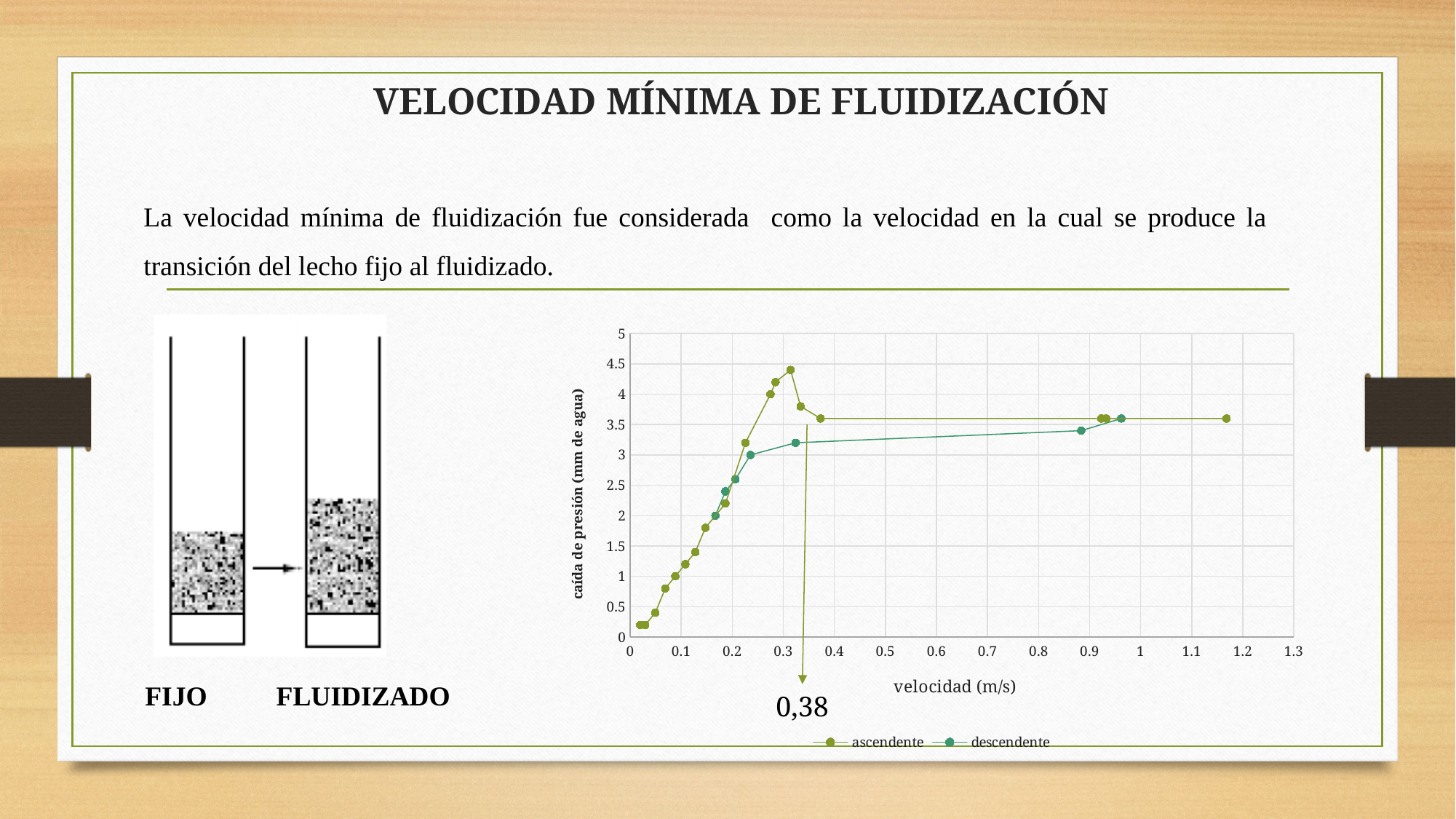
Is the highest value of the ascendente series greater or less than 4? greater What velocity value is marked by the arrow annotation below the chart? 0,38 What kind of chart is shown on the slide? line chart Is the ascendente value at the lowest plotted velocity greater or less than 0.5? less What is the title of the chart's vertical axis? caída de presión (mm de agua) Which series reaches the highest pressure drop on the chart? ascendente What are the two series named in the chart legend? ascendente, descendente Around a velocity of 0.3 m/s, which series shows the higher pressure drop, ascendente or descendente? ascendente How many series does the chart legend list? 2 Does the ascendente series rise or fall as velocity increases from 0 to 0.3 m/s? rise Is the lowest value of the descendente series greater or less than 1.5? greater